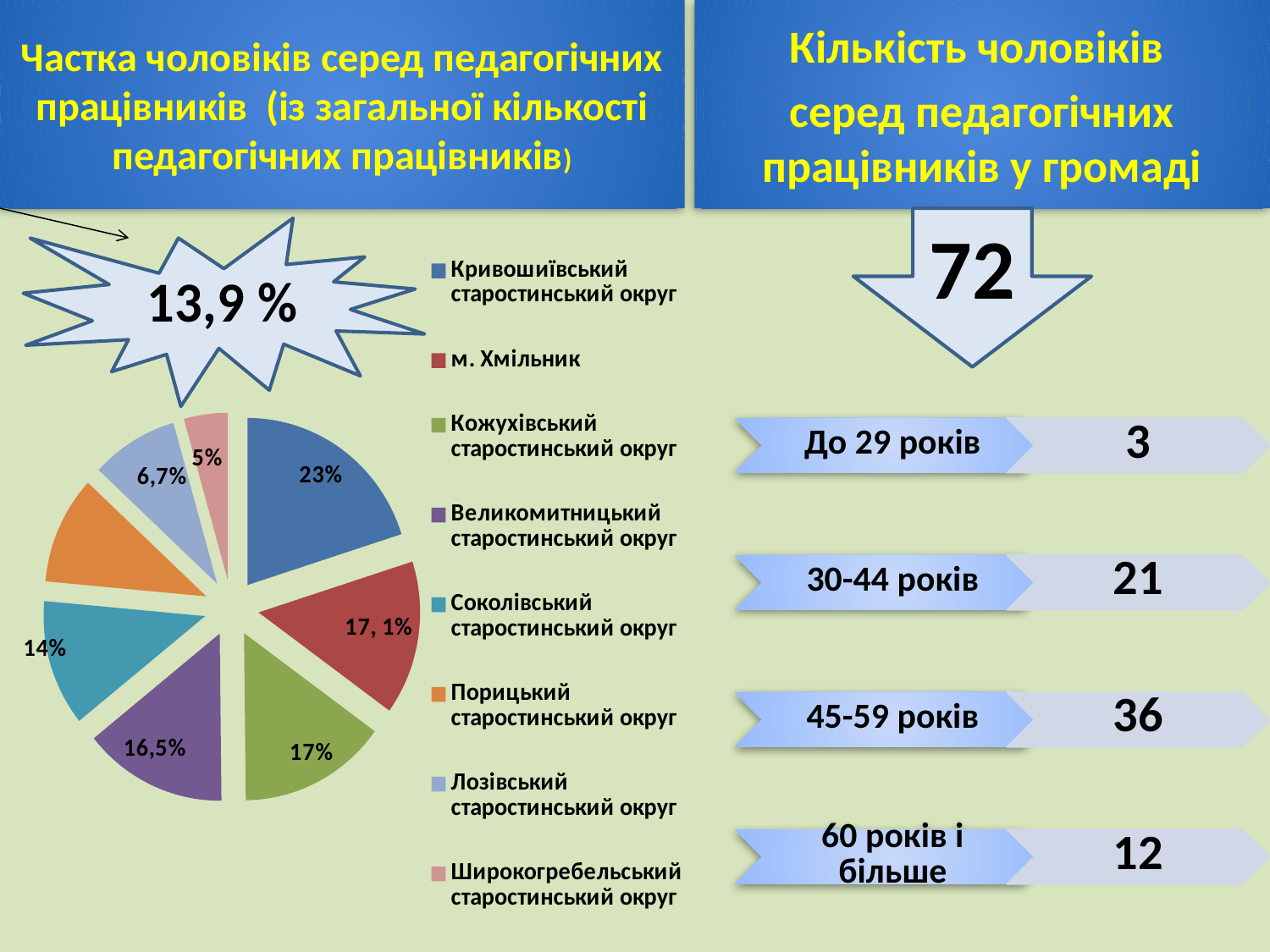
In the pie chart, which is larger: the share for Соколівський старостинський округ or for Лозівський старостинський округ? Соколівський старостинський округ In the pie chart, what share is shown for Соколівський старостинський округ? 14% What kind of chart is shown on the left side of the slide? pie chart In the pie chart, what share is shown for Кожухівський старостинський округ? 17% In the pie chart, what share is shown for Кривошиївський старостинський округ? 23% Which category has the smallest slice in the pie chart? Широкогребельський старостинський округ How many categories does the legend of the pie chart list? 8 In the pie chart, what share is shown for Широкогребельський старостинський округ? 5% In the pie chart, what share is shown for Великомитницький старостинський округ? 16,5% In the pie chart, what share is shown for м. Хмільник? 17, 1% In the pie chart, what share is shown for Лозівський старостинський округ? 6,7% Which category has the largest slice in the pie chart? Кривошиївський старостинський округ